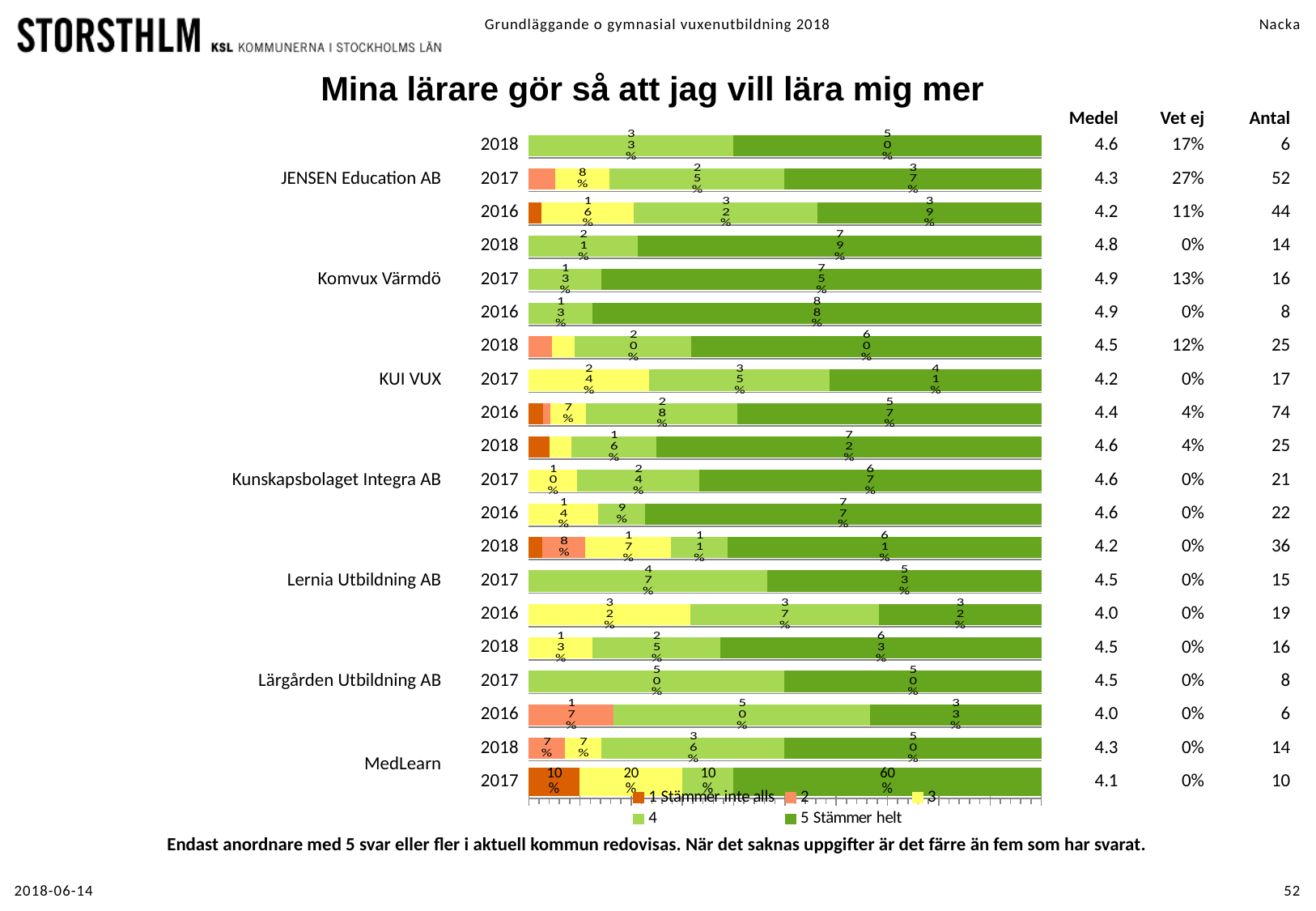
Which is larger: the '5 Stämmer helt' value for JENSEN Education AB in 2018 or for KUI VUX in 2018? KUI VUX 2018 What is the '4' value for Lernia Utbildning AB in 2017? 47% Which bar has the highest '5 Stämmer helt' value? Komvux Värmdö 2016 What is the title of the chart? Mina lärare gör så att jag vill lära mig mer What is the '1 Stämmer inte alls' value for MedLearn in 2017? 10% What is the '3' value for KUI VUX in 2017? 24% How many series does the chart legend list? 5 What is the label of the darkest green series in the legend? 5 Stämmer helt What is the '5 Stämmer helt' value for Komvux Värmdö in 2016? 88% What kind of chart is shown on the slide? Stacked bar chart What is the difference between the '5 Stämmer helt' values for Kunskapsbolaget Integra AB in 2018 and 2017? 5 percentage points How many bars (provider-year rows) are plotted in the chart? 20